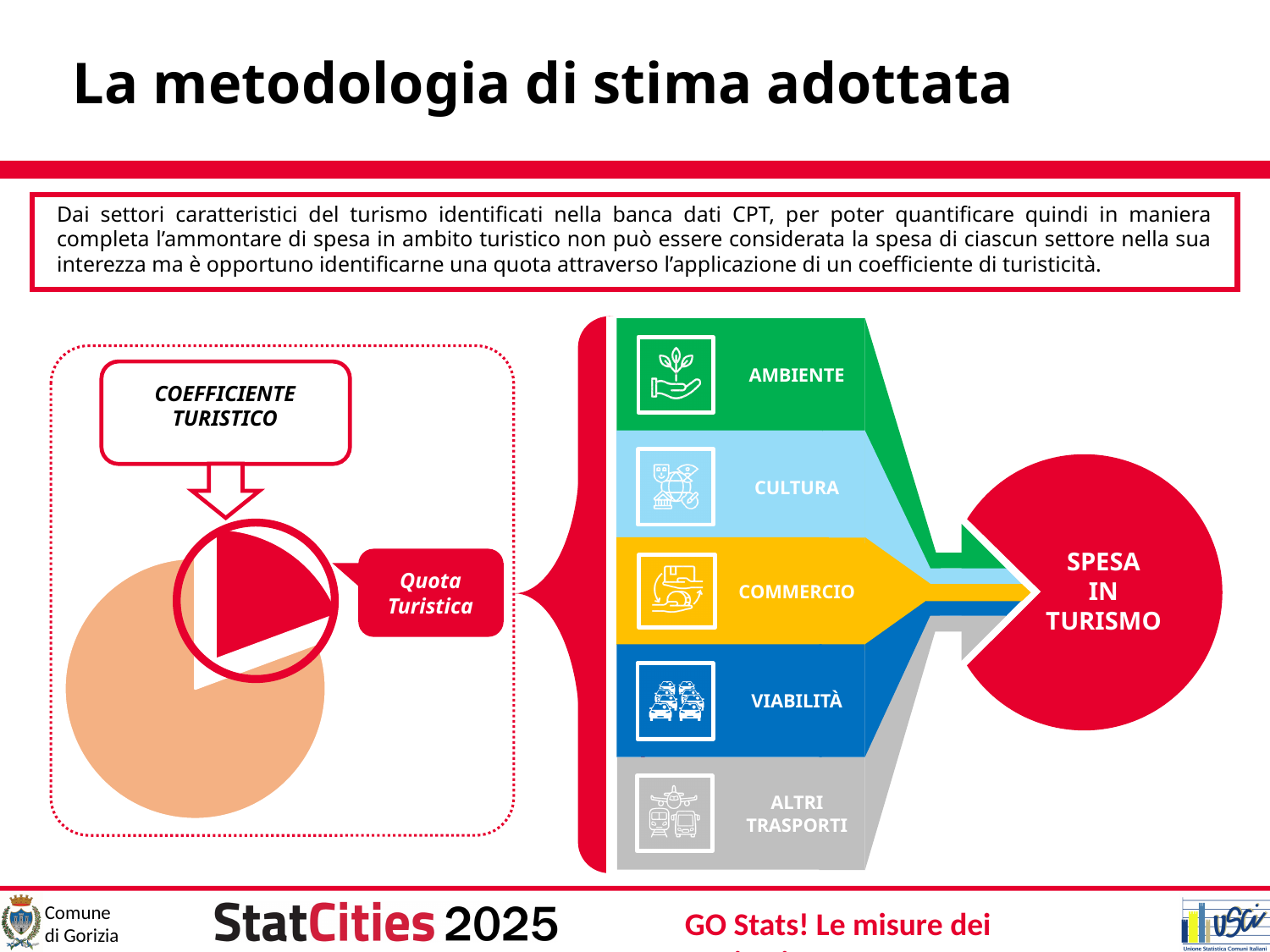
In the pie chart on the left, which slice is larger: the red slice labelled "Quota Turistica" or the orange remainder? the orange remainder In the pie chart on the left, what colour is the slice labelled "Quota Turistica"? red How many slices does the pie chart on the left of the slide have? 2 In the pie chart on the left, what label is attached to the red slice? Quota Turistica What kind of chart is shown inside the dotted box on the left of the slide? pie chart